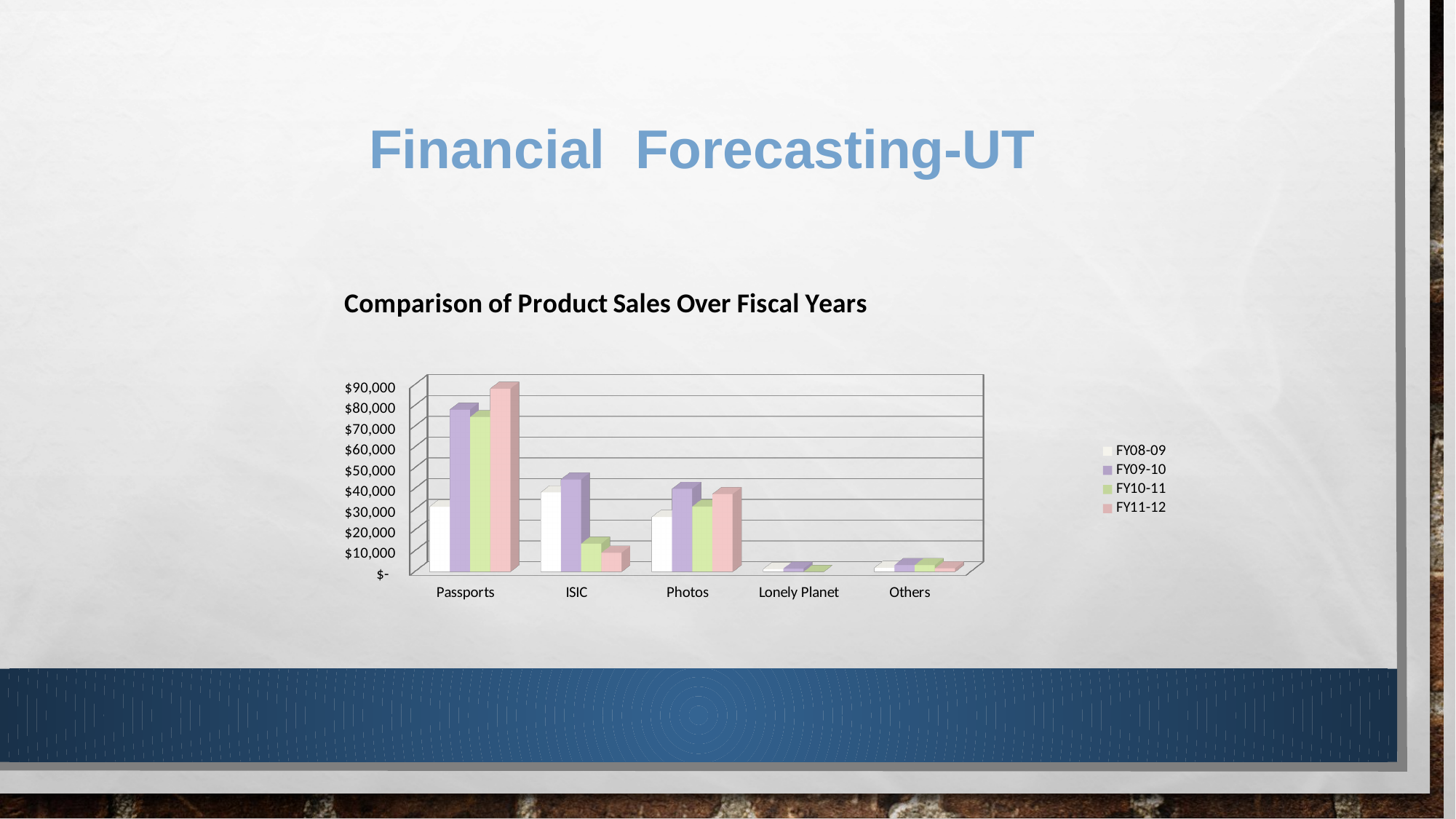
How many product categories are shown on the x axis? 5 Is the FY09-10 value for Photos greater or less than $30,000? greater For Passports, which is larger: the FY09-10 value or the FY11-12 value? FY11-12 Which product category has the highest FY11-12 sales? Passports What is the title of the chart? Comparison of Product Sales Over Fiscal Years Is the FY11-12 value for Passports greater or less than $80,000? greater For ISIC, which is larger: the FY09-10 value or the FY10-11 value? FY09-10 Is the FY08-09 value for Passports greater or less than $40,000? less What type of chart is shown on the slide? Bar chart How many series does the legend list? 4 Which product category has the lowest sales across all fiscal years? Lonely Planet